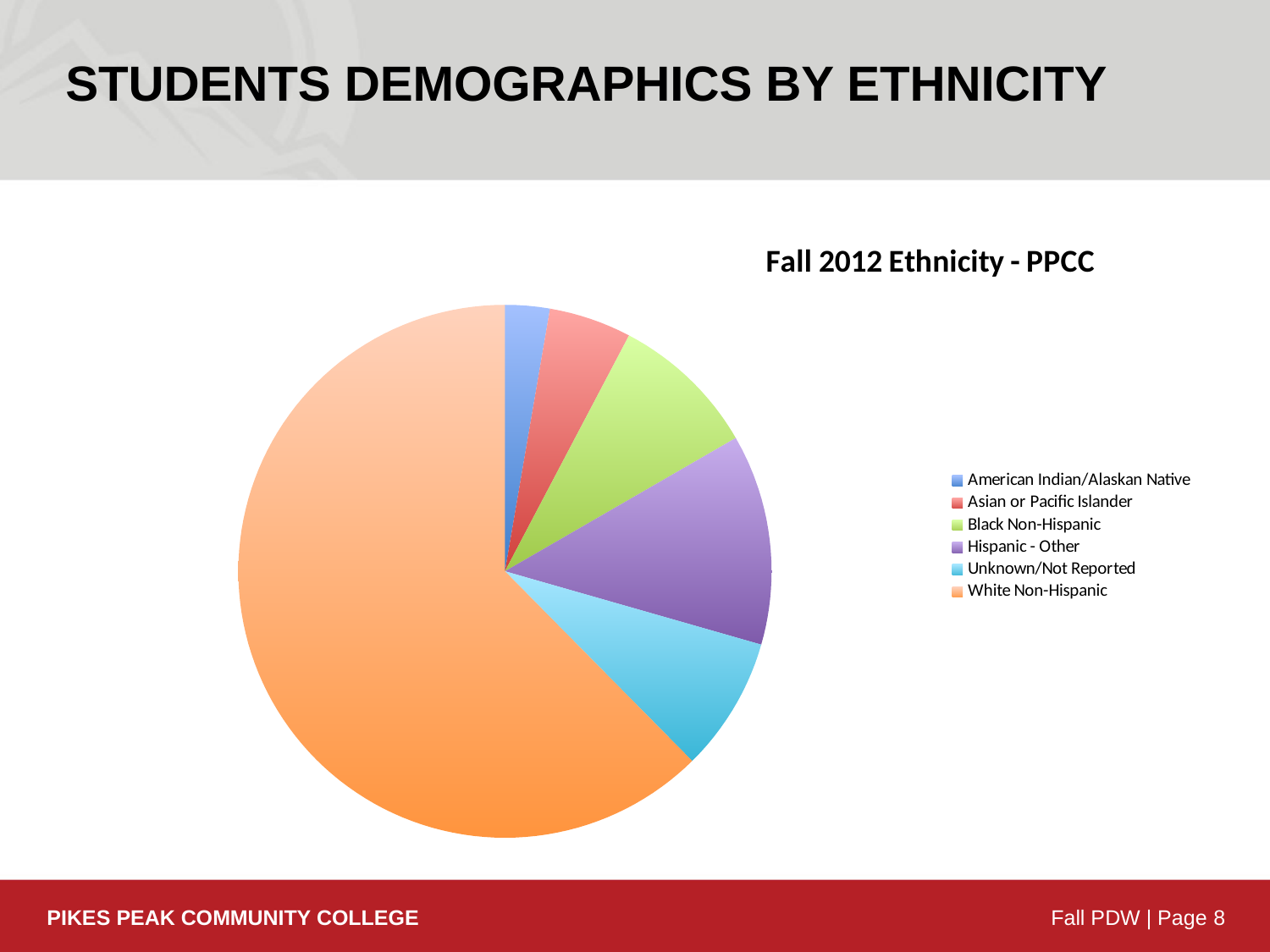
Which ethnicity category has the smallest slice of the pie? American Indian/Alaskan Native What kind of chart is shown on the slide? pie chart Which slice is larger, Asian or Pacific Islander or American Indian/Alaskan Native? Asian or Pacific Islander Which slice is larger, Hispanic - Other or Unknown/Not Reported? Hispanic - Other Which ethnicity category has the largest slice of the pie? White Non-Hispanic Which slice is larger, White Non-Hispanic or Hispanic - Other? White Non-Hispanic Which colour represents Unknown/Not Reported in the legend? light blue How many ethnicity categories does the pie chart show? 6 Does the White Non-Hispanic slice make up more or less than half of the pie? more What is the title of the chart? Fall 2012 Ethnicity - PPCC